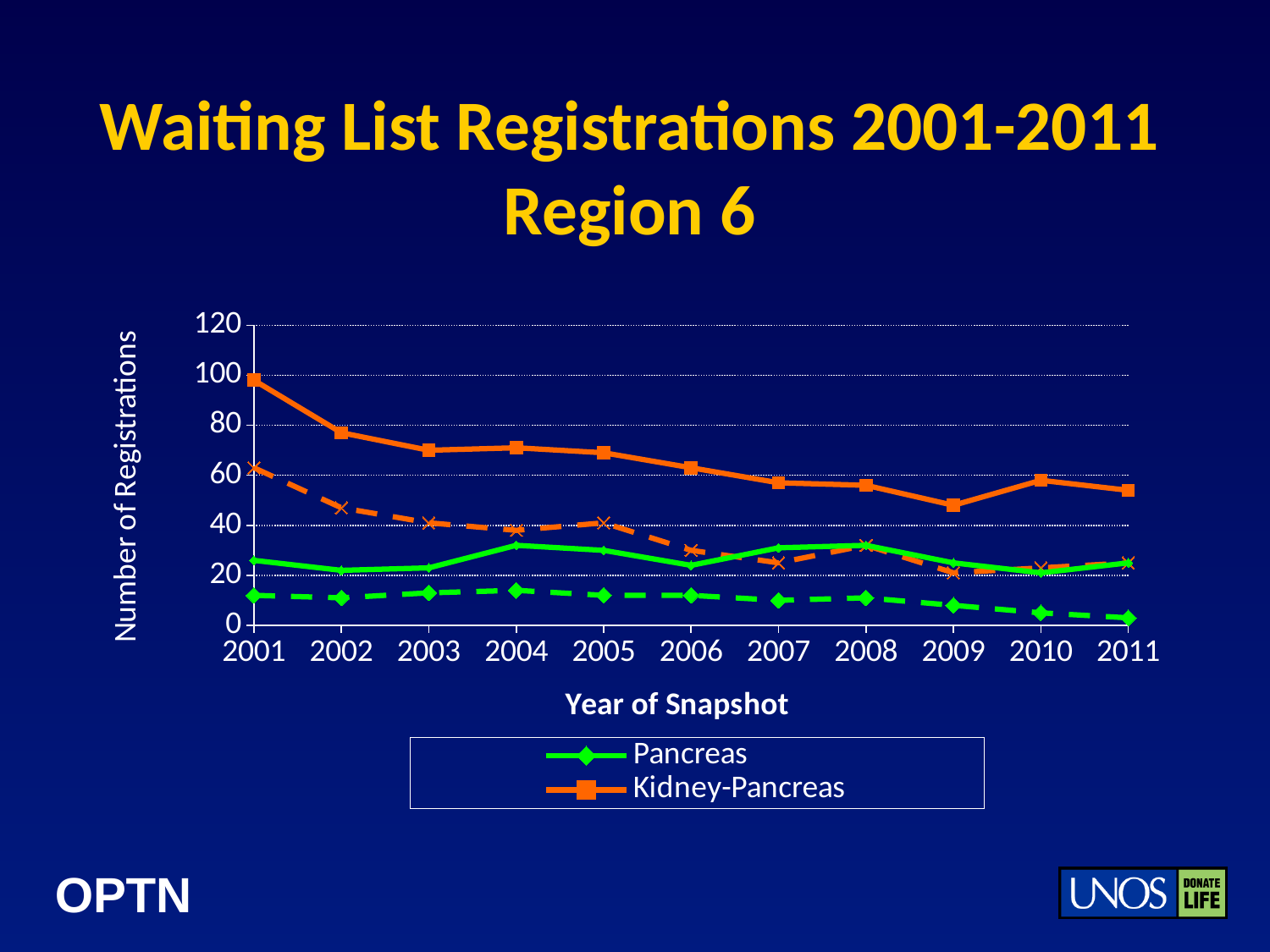
Is the Kidney-Pancreas value for 2009 greater or less than 60? less Is the Pancreas value for 2001 greater or less than 40? less In 2001, which series has the larger value, Pancreas or Kidney-Pancreas? Kidney-Pancreas How many years are plotted along the x axis? 11 In which year is the Kidney-Pancreas series lowest? 2009 Does the Kidney-Pancreas series generally rise or fall from 2001 to 2011? fall How many series does the legend list? 2 In which year is the Kidney-Pancreas series highest? 2001 What is the title of the x axis? Year of Snapshot Is the Kidney-Pancreas value for 2001 greater or less than 80? greater What kind of chart is shown on the slide? line chart